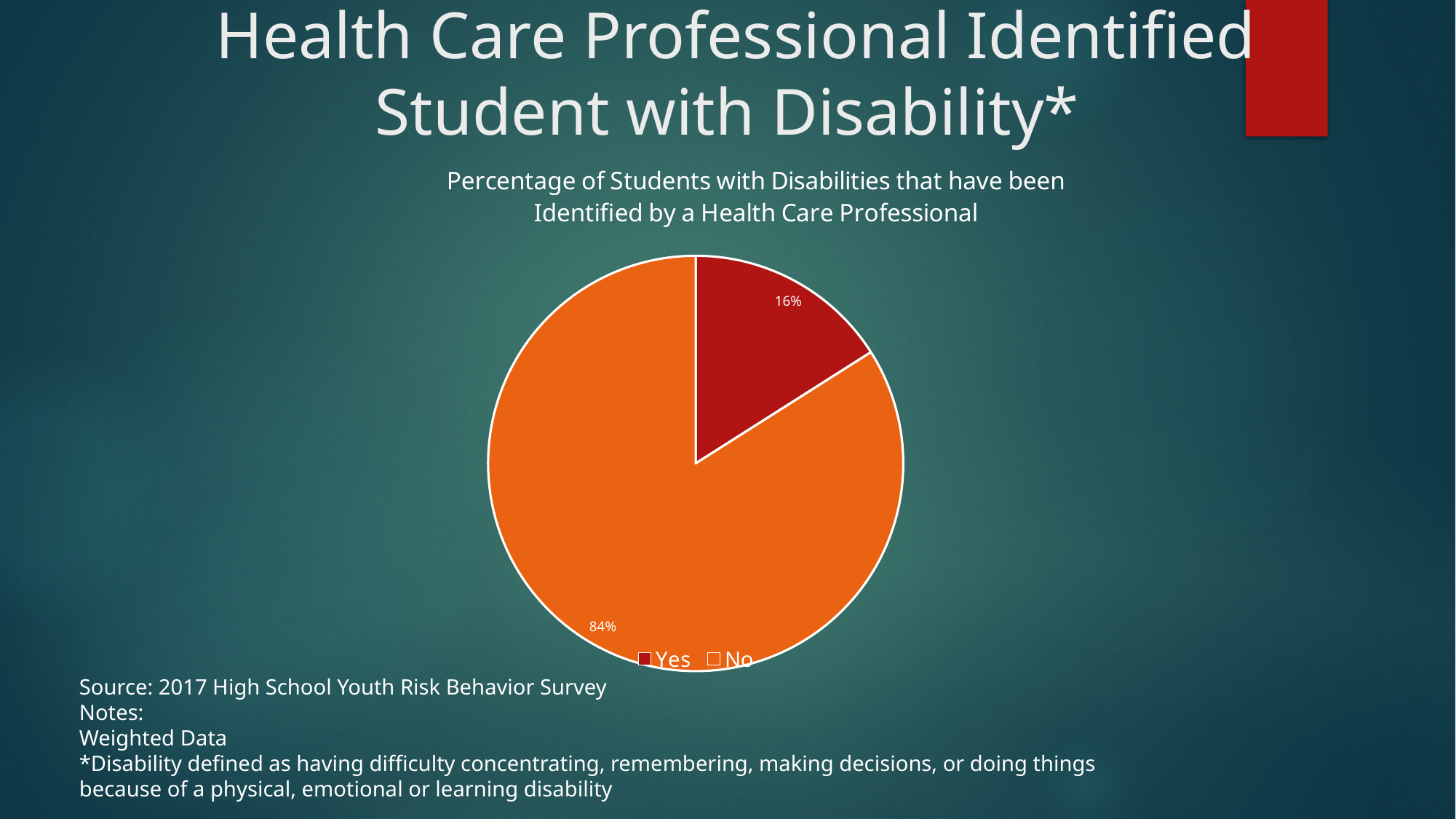
How many entries does the legend list? 2 Which slice of the pie is the smallest? Yes What is the title of the chart? Percentage of Students with Disabilities that have been Identified by a Health Care Professional Which slice of the pie is the largest? No What kind of chart is shown on the slide? Pie chart What percentage of students with disabilities have been identified by a health care professional (Yes)? 16% What is the difference between the No and Yes percentages? 68% What colour is the Yes slice in the pie chart? Dark red Which is larger, the Yes slice or the No slice? No How many slices does the pie chart have? 2 What percentage of students with disabilities have not been identified by a health care professional (No)? 84% What share of the pie does the Yes slice represent? 16%